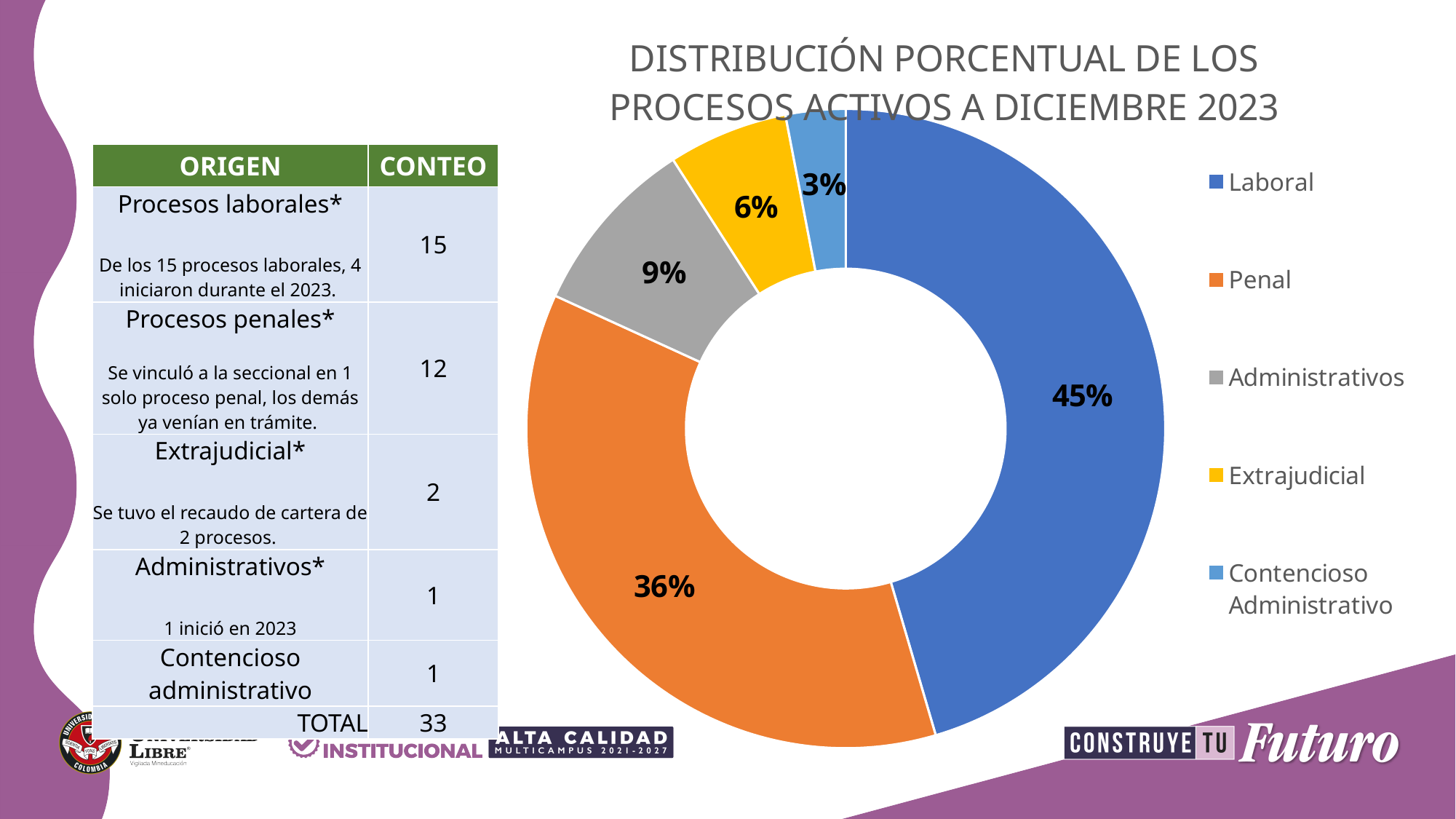
What type of chart is shown on the slide? Donut (pie) chart How many categories does the donut chart show? 5 What percentage of the donut chart does Penal represent? 36% What percentage of the donut chart does Contencioso Administrativo represent? 3% Which category has the smallest share of the donut chart? Contencioso Administrativo Which category has the largest share of the donut chart? Laboral What is the difference in percentage points between the Laboral and Penal shares? 9 Which has a larger share, Administrativos or Extrajudicial? Administrativos What percentage of the donut chart does Administrativos represent? 9% What percentage of the donut chart does Laboral represent? 45% What percentage of the donut chart does Extrajudicial represent? 6% What is the title of the chart? DISTRIBUCIÓN PORCENTUAL DE LOS PROCESOS ACTIVOS A DICIEMBRE 2023